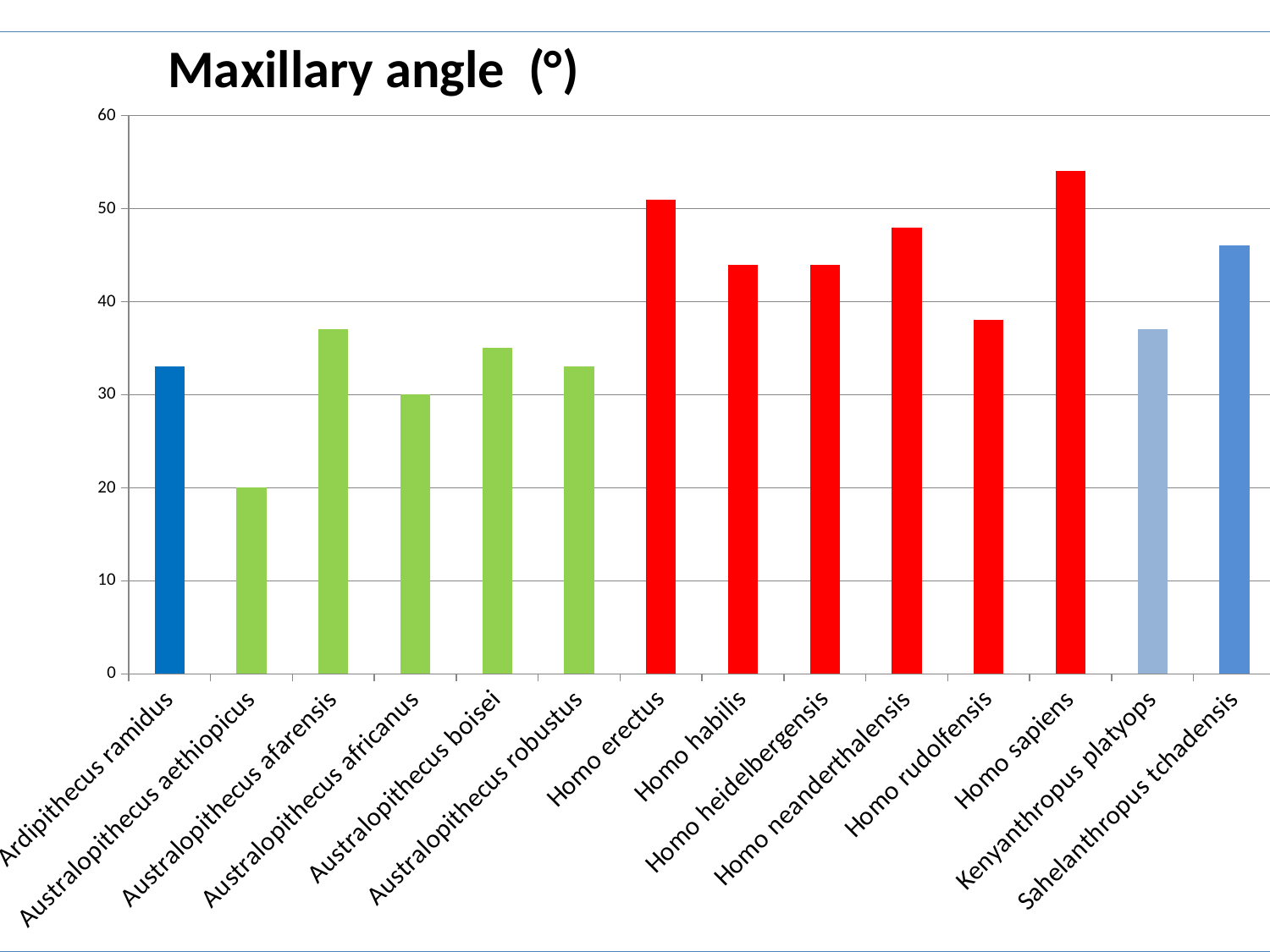
What is the maxillary angle for Australopithecus africanus? 30 Is the value for Homo erectus greater or less than 50? greater What type of chart is shown on the slide? bar chart How many species (categories) are plotted in the chart? 14 What is the maxillary angle for Australopithecus aethiopicus? 20 Which species has the lowest maxillary angle? Australopithecus aethiopicus Which species has the highest maxillary angle? Homo sapiens Is the value for Sahelanthropus tchadensis greater or less than 40? greater What is the title of the chart? Maxillary angle (°) Which has a larger maxillary angle, Australopithecus afarensis or Australopithecus africanus? Australopithecus afarensis Is the value for Homo rudolfensis greater or less than 40? less Which has a larger maxillary angle, Homo erectus or Homo habilis? Homo erectus